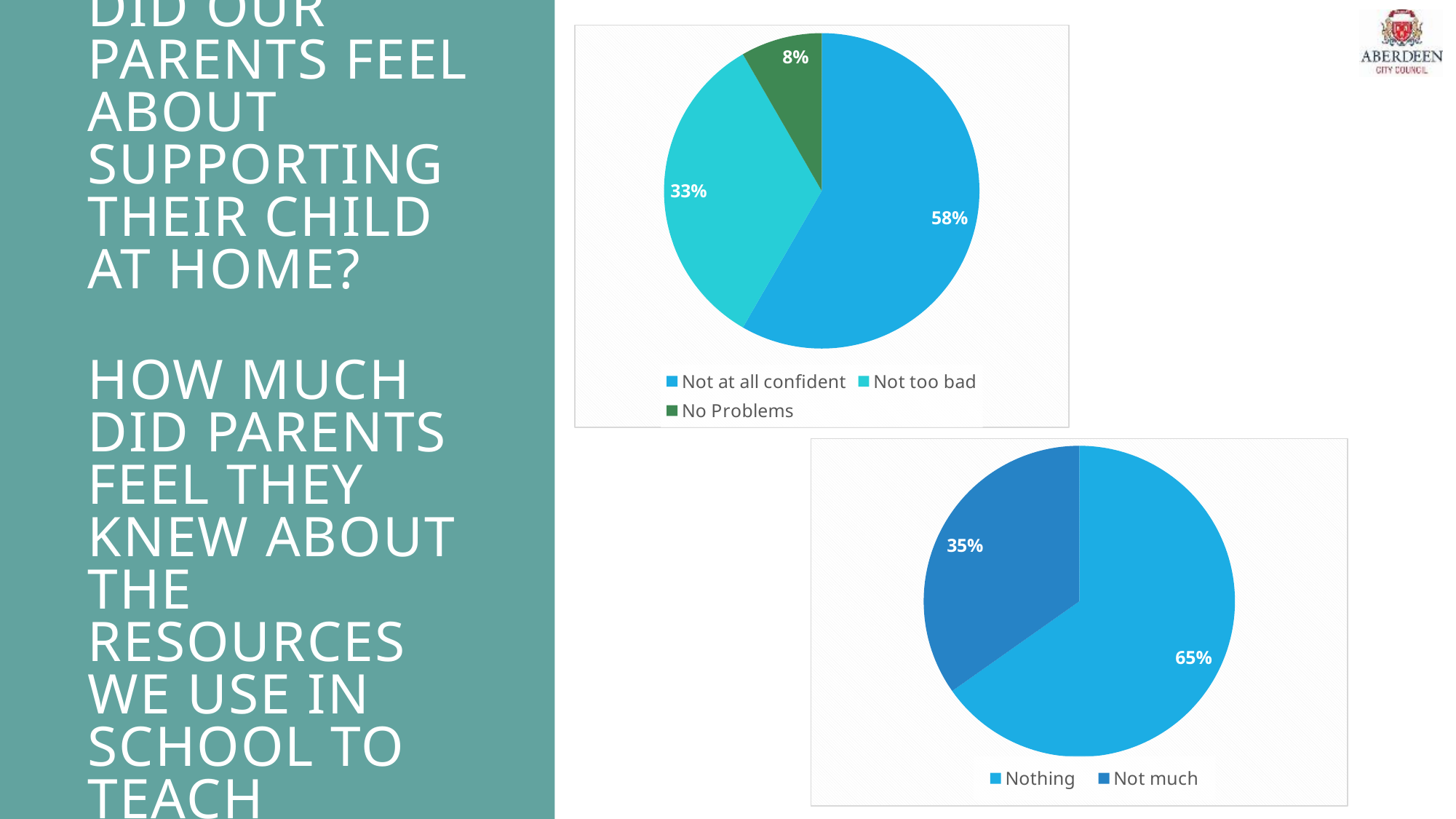
How many categories does the top pie chart show? 3 In the bottom pie chart, what percentage is shown for 'Not much'? 35% In the top pie chart, what percentage is shown for 'Not too bad'? 33% In the bottom pie chart, what percentage is shown for 'Nothing'? 65% In the bottom pie chart, which is larger: 'Nothing' or 'Not much'? Nothing In the top pie chart, which category has the smallest slice? No Problems In the top pie chart, what share of parents answered 'Not at all confident'? 58% In the top pie chart, what is the difference in percentage points between 'Not at all confident' and 'Not too bad'? 25 What type of chart is the bottom chart on the slide? Pie chart In the top pie chart, which category has the largest slice? Not at all confident In the top pie chart, what percentage is shown for 'No Problems'? 8% In the bottom pie chart, what is the difference in percentage points between 'Nothing' and 'Not much'? 30